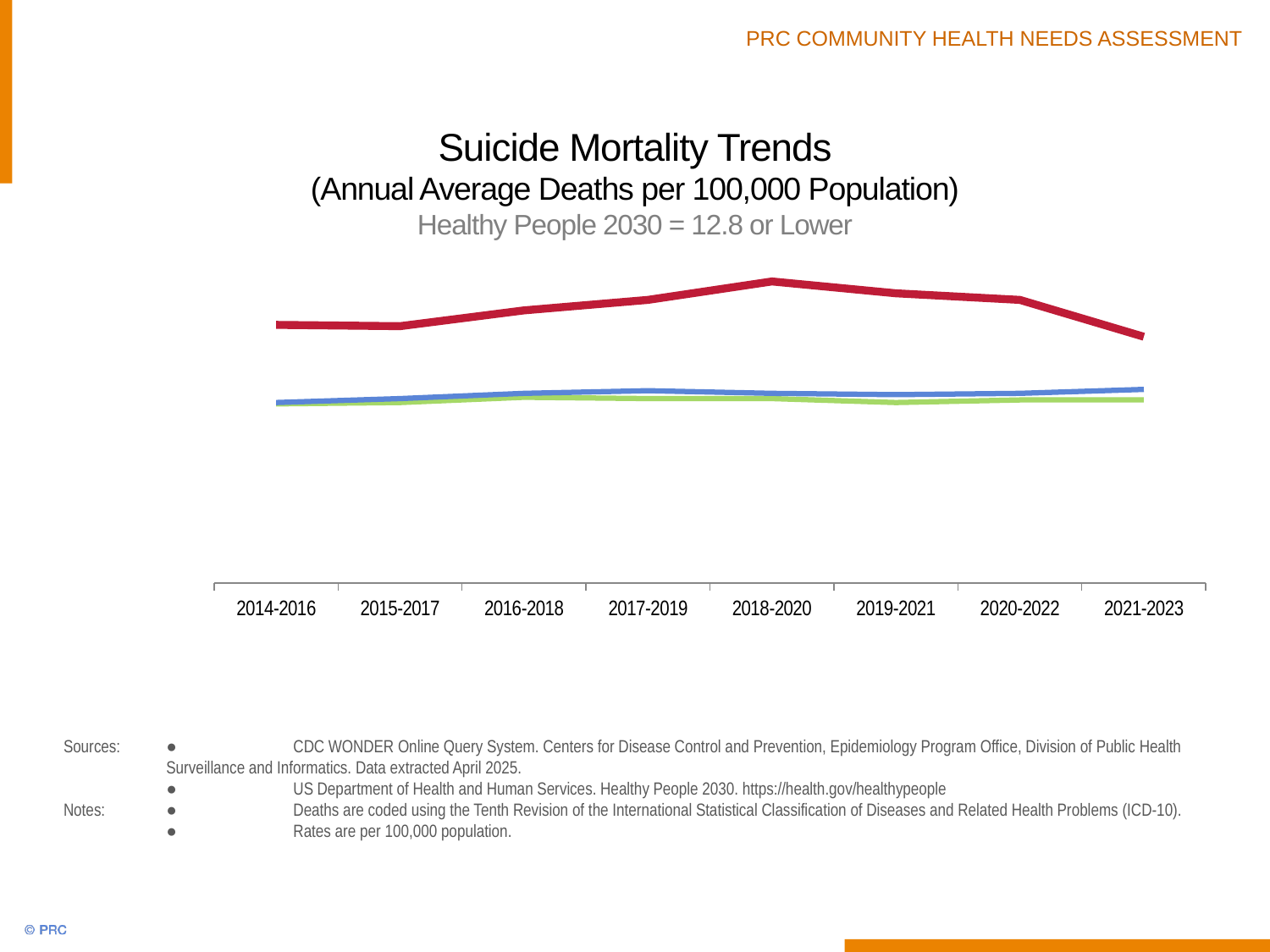
In which period does the red line reach its highest point? 2018-2020 What Healthy People 2030 target is stated below the chart title? 12.8 or Lower In 2021-2023, is the red line higher or lower than the blue line? higher How many lines are plotted on the chart? 3 What kind of chart is shown on the slide? line chart Does the red line rise or fall from 2014-2016 to 2018-2020? rise How many time periods are shown along the x axis? 8 What is the title of the chart? Suicide Mortality Trends (Annual Average Deaths per 100,000 Population) Does the red line rise or fall from 2018-2020 to 2021-2023? fall In 2018-2020, is the red line higher or lower than the green line? higher